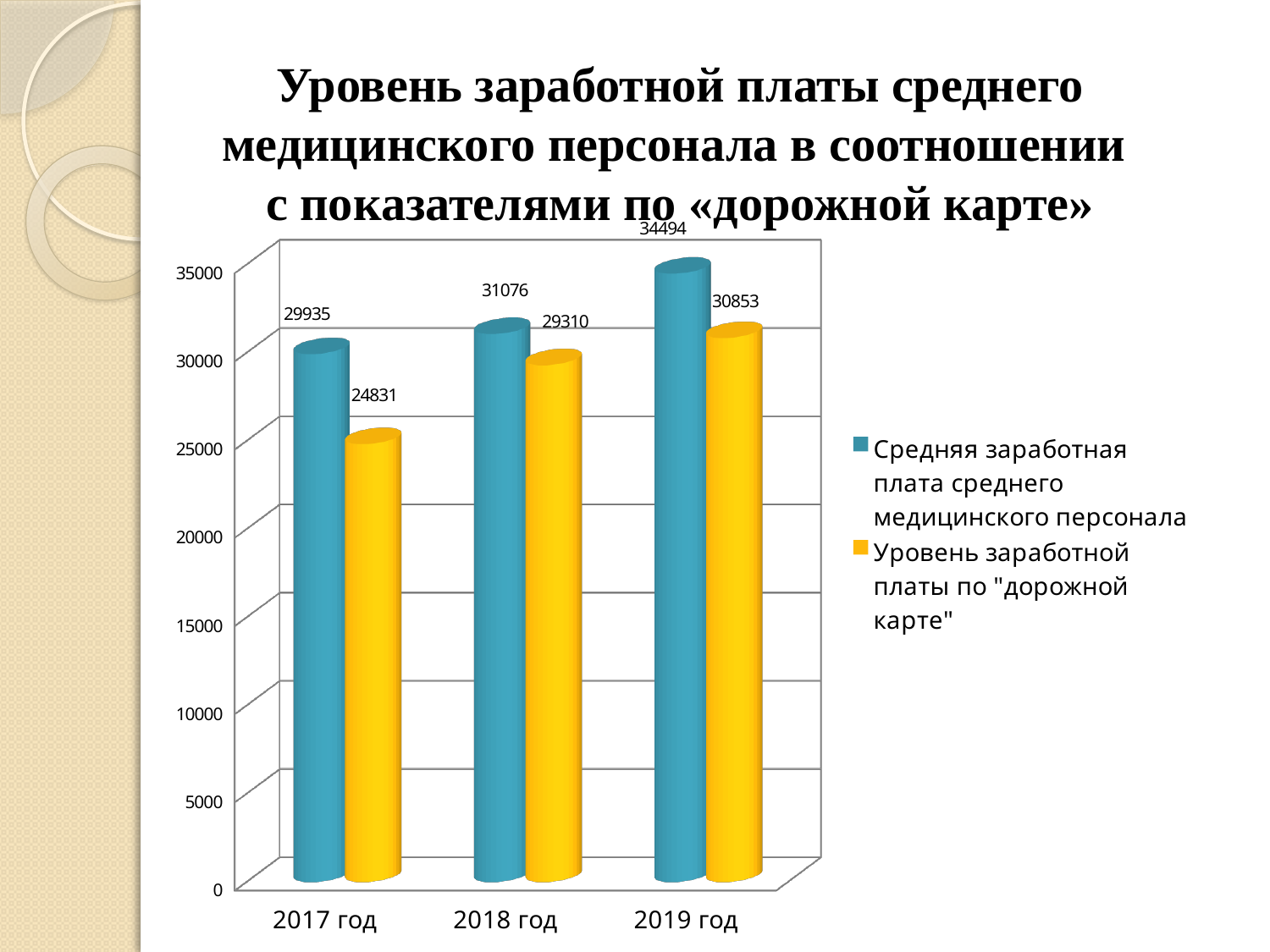
In which year is 'Уровень заработной платы по "дорожной карте"' the lowest? 2017 год What is the value of 'Средняя заработная плата среднего медицинского персонала' for 2019 год? 34494 Which is larger in 2019 год: 'Средняя заработная плата среднего медицинского персонала' or 'Уровень заработной платы по "дорожной карте"'? Средняя заработная плата среднего медицинского персонала Is the value of 'Уровень заработной платы по "дорожной карте"' for 2017 год greater or less than 25000? less Does 'Средняя заработная плата среднего медицинского персонала' rise or fall from 2017 год to 2019 год? rise How many years are shown on the x axis? 3 What is the value of 'Средняя заработная плата среднего медицинского персонала' for 2017 год? 29935 What is the difference between 'Средняя заработная плата среднего медицинского персонала' in 2019 год and in 2018 год? 3418 In which year is 'Средняя заработная плата среднего медицинского персонала' the highest? 2019 год What is the difference between 'Средняя заработная плата среднего медицинского персонала' and 'Уровень заработной платы по "дорожной карте"' in 2017 год? 5104 What is the value of 'Уровень заработной платы по "дорожной карте"' for 2018 год? 29310 How many series does the legend list? 2